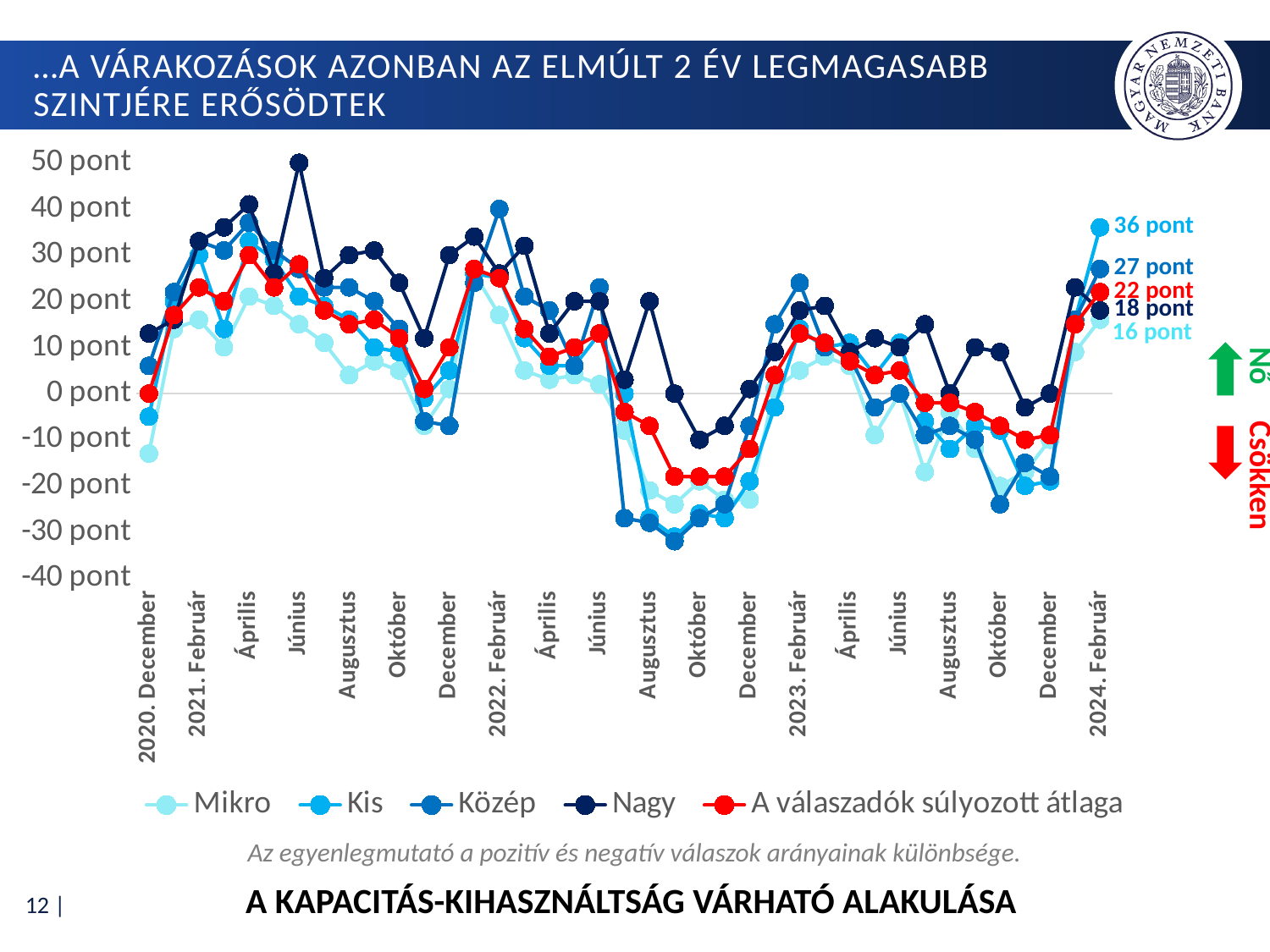
What is the value for the Mikro series in 2024. Február? 16 pont What is the title of the chart shown at the bottom of the slide? A kapacitás-kihasználtság várható alakulása Which series has the lowest value in 2024. Február? Mikro How many series does the legend list? 5 What is the value for the Nagy series in 2024. Február? 18 pont Which series has the highest value in 2024. Február? Kis What kind of chart is shown on the slide? line chart What is the difference between the Kis and Mikro values in 2024. Február? 20 pont Is the value for the Nagy series in 2021 Június greater or less than 40 pont? greater What is the value for 'A válaszadók súlyozott átlaga' in 2024. Február? 22 pont What is the value for the Kis series in 2024. Február? 36 pont What is the value for the Közép series in 2024. Február? 27 pont